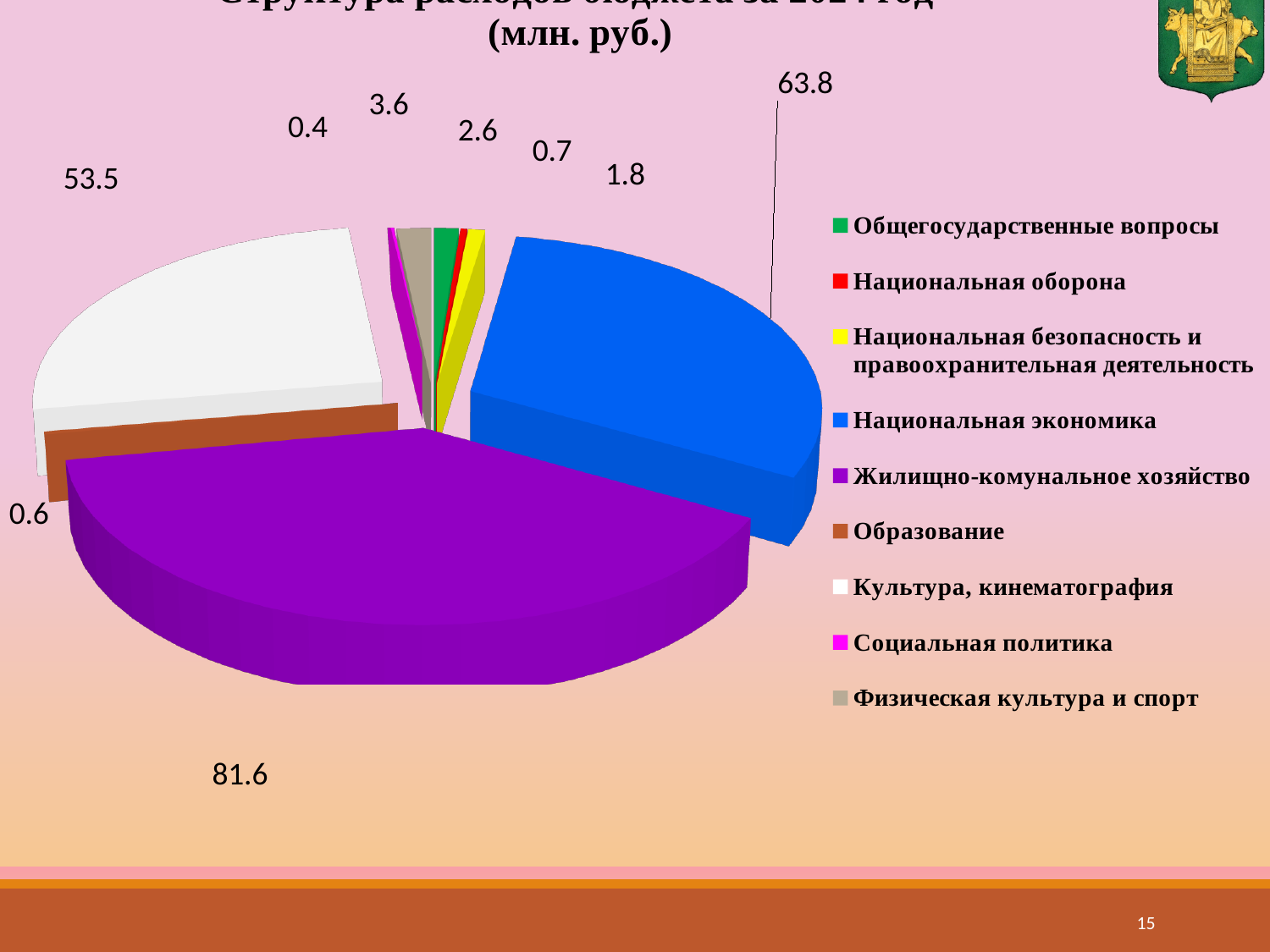
What kind of chart is shown on the slide? pie chart What is the value for Культура, кинематография? 53.5 Which is larger: the value for Национальная экономика or the value for Культура, кинематография? Национальная экономика What is the difference between the values for Жилищно-комунальное хозяйство and Национальная экономика? 17.8 Which category has the smallest value? Социальная политика What is the value for Национальная экономика? 63.8 What is the value for Образование? 0.6 What is the value for Физическая культура и спорт? 3.6 Which category has the largest slice of the pie? Жилищно-комунальное хозяйство What is the value for Жилищно-комунальное хозяйство? 81.6 How many categories (slices) does the pie chart have? 9 What colour is the slice for Национальная экономика? blue